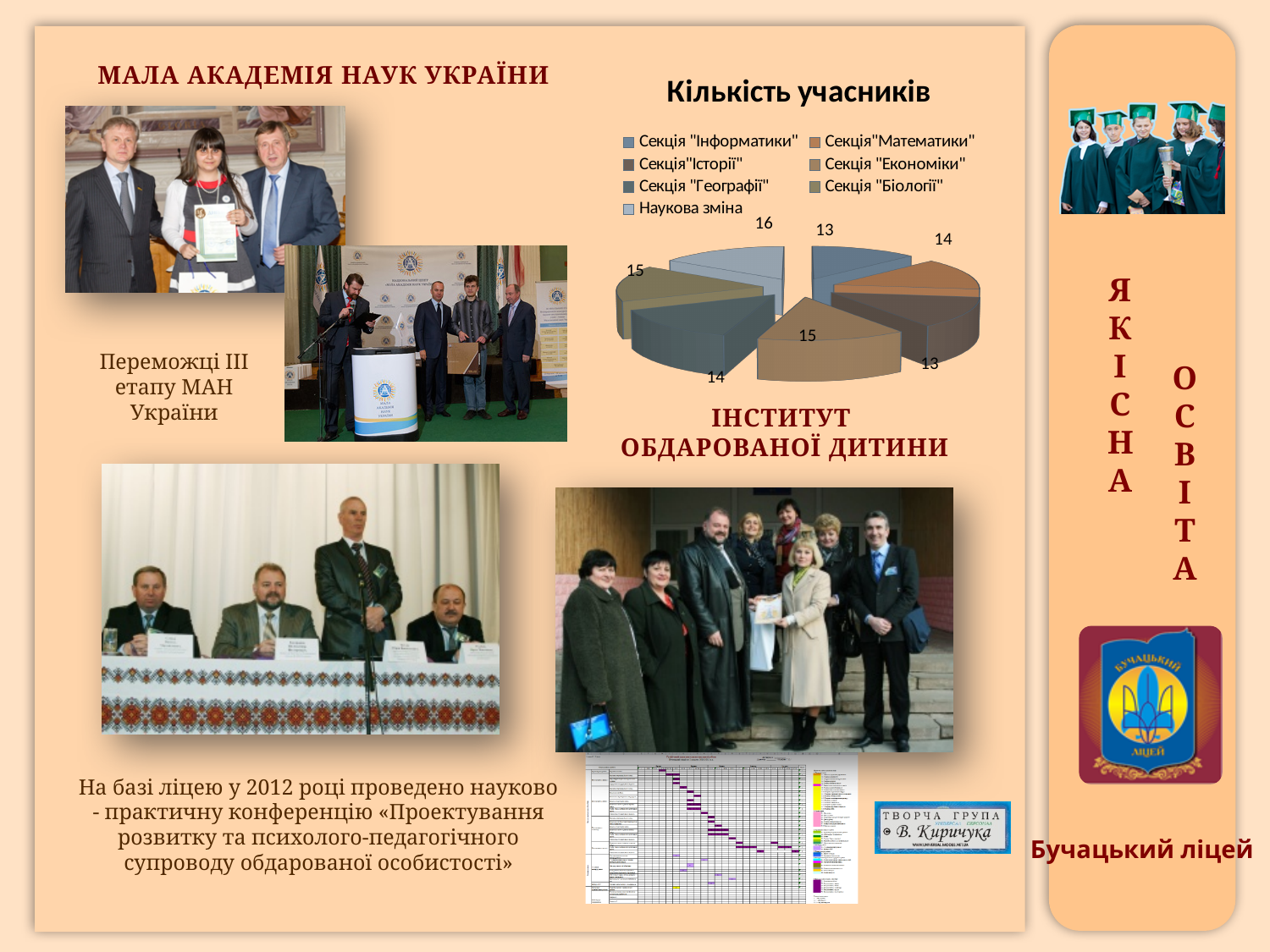
What kind of chart is shown under the title "Кількість учасників"? pie chart What is the value for "Наукова зміна" in the "Кількість учасників" pie chart? 16 How many entries does the legend of the "Кількість учасників" chart list? 7 How many slices in the "Кількість учасників" pie chart are labelled 15? 2 What share of the whole does the slice labelled 16 represent in the "Кількість учасників" pie chart? 16% How many slices does the "Кількість учасників" pie chart have? 7 What is the difference between the largest and smallest slice values in the "Кількість учасників" pie chart? 3 In the "Кількість учасників" pie chart, which is larger: the slice labelled 16 or the slice labelled 14? 16 What is the total of all slice values in the "Кількість учасників" pie chart? 100 What is the largest value shown on the "Кількість учасників" pie chart? 16 What is the title of the chart on the slide? Кількість учасників What is the smallest value shown on the "Кількість учасників" pie chart? 13